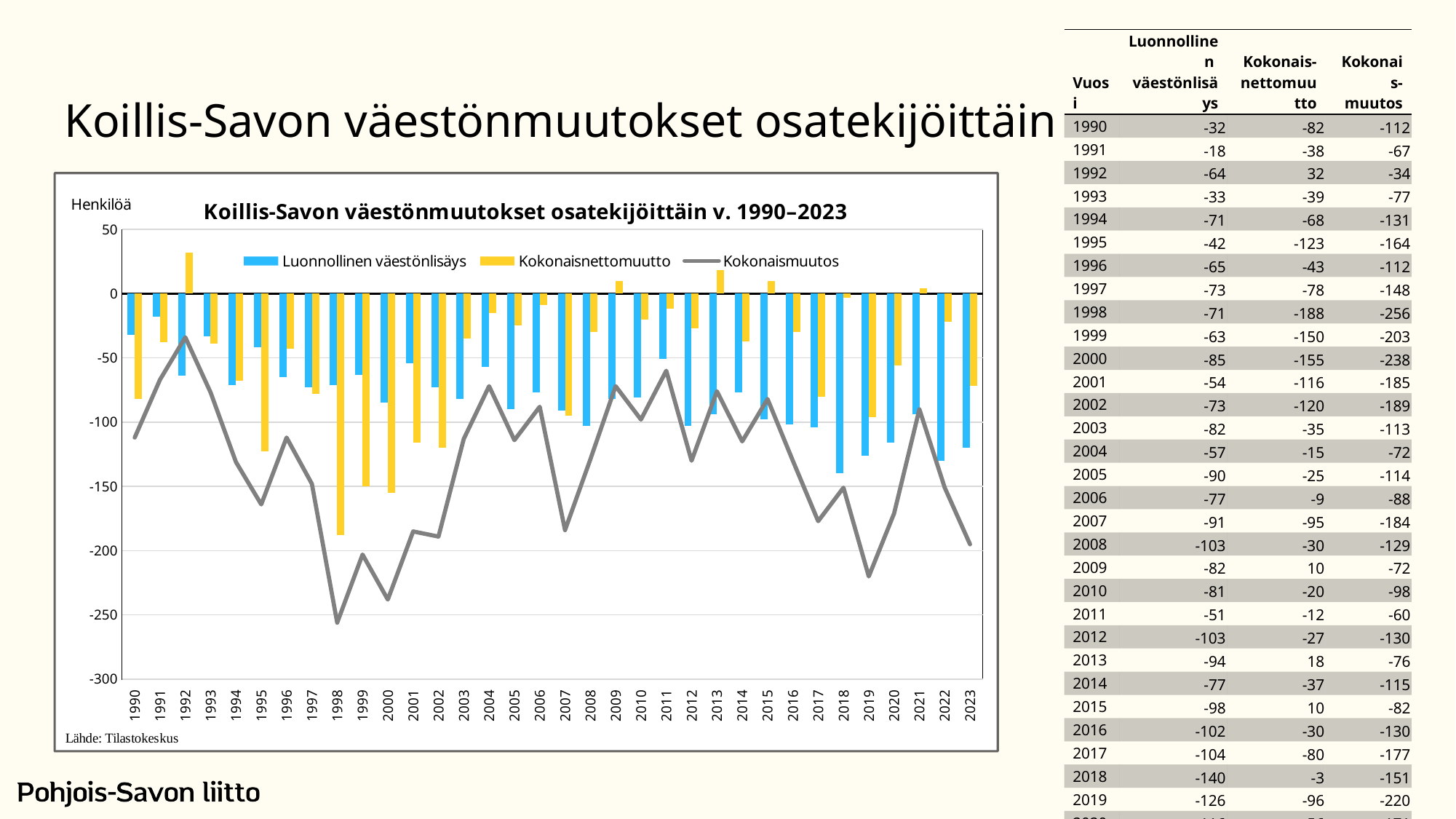
In which year is Kokonaisnettomuutto at its highest? 1992 In which year is Kokonaismuutos at its lowest? 1998 What is the Kokonaismuutos value for 1998? -256 How many series does the chart legend list? 3 What kind of chart is shown on the slide? A bar chart combined with a line Which year has the lower Luonnollinen väestönlisäys, 2011 or 2018? 2018 Does the Kokonaismuutos line rise or fall from 1992 to 1998? fall What is the Kokonaisnettomuutto value for 1992? 32 How many years are shown on the x axis of the chart? 34 Is the Kokonaismuutos value for 2023 greater or less than -150? less What source is cited below the chart? Tilastokeskus What is the difference between the Kokonaismuutos values for 1998 and 1999? 53